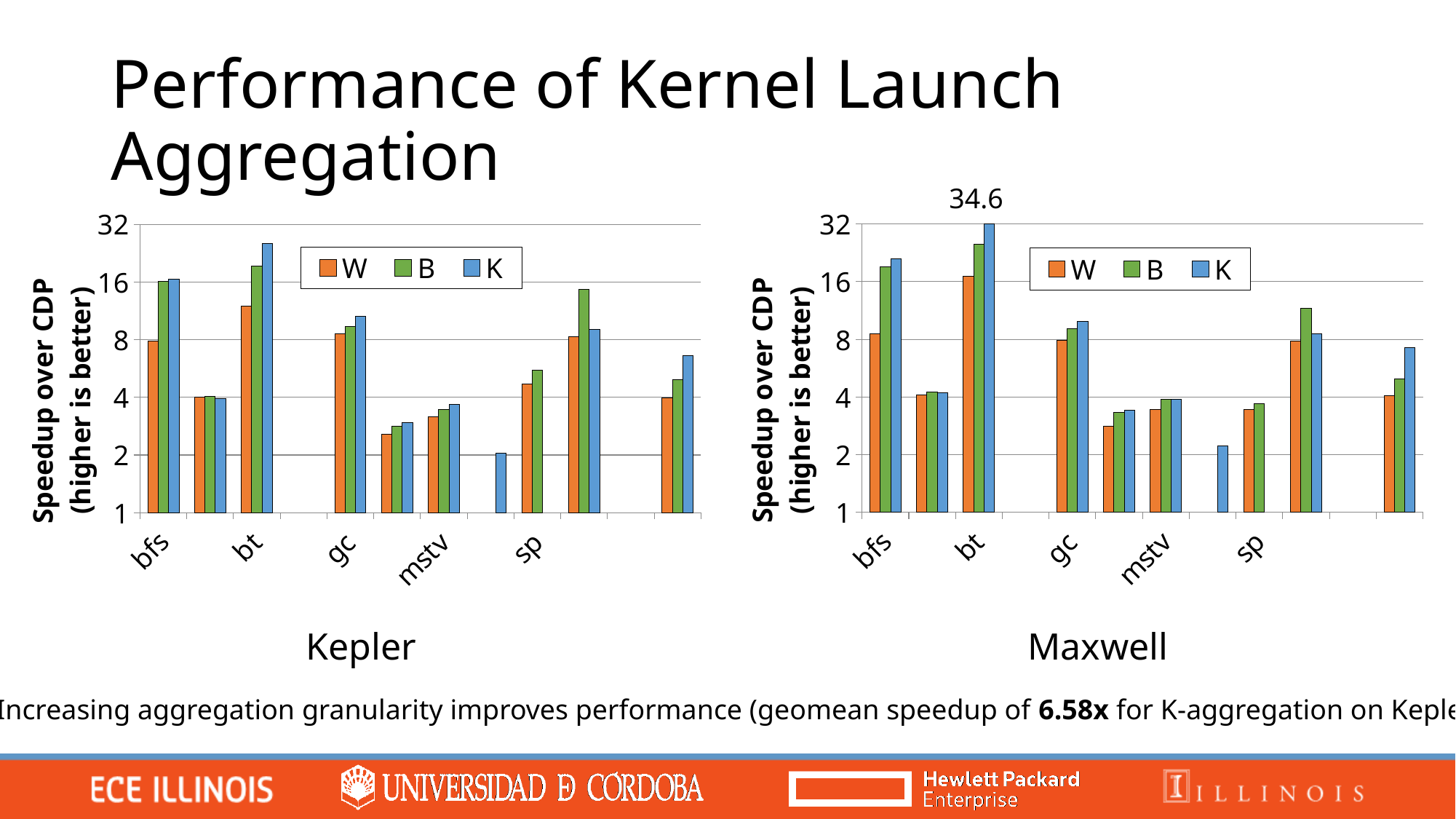
What are the legend entries in the Maxwell chart? W, B, K What kind of chart is the Kepler chart? bar chart In the Kepler chart, which series has the highest value for bt? K What is the y-axis title of the Kepler chart? Speedup over CDP (higher is better) How many series does the legend of the Kepler chart list? 3 In the Kepler chart, which is larger for bfs, the W value or the B value? B In the Maxwell chart, which labelled category has the highest K value? bt In the Kepler chart, is the K value for bfs greater or less than 8? greater In the Maxwell chart, which series has the highest value for bt? K In the Maxwell chart, is the W value for bfs greater or less than 16? less In the Kepler chart, is the W value for mstv greater or less than 4? less In the Maxwell chart, what is the labelled value of the K bar for bt? 34.6